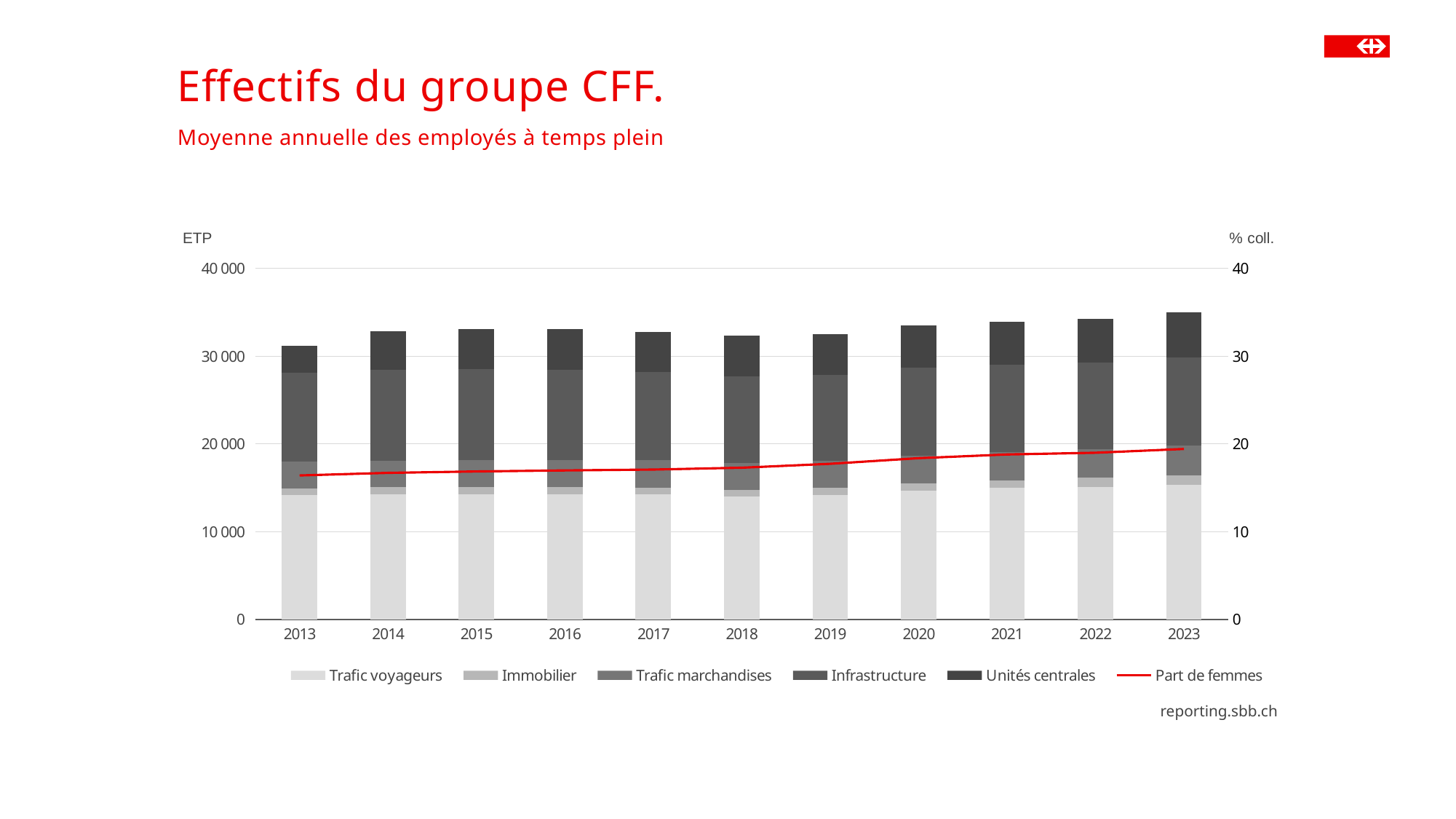
Is the total bar for 2013 greater or less than 30 000? greater Which year has the lowest total bar? 2013 Which year has the larger total bar, 2018 or 2021? 2021 How many years are shown on the x axis? 11 Is the Part de femmes value for 2013 greater or less than 20? less What is the title of the chart slide? Effectifs du groupe CFF. How many series does the legend list? 6 Is the total bar for 2023 greater or less than 40 000? less What kind of chart is shown on the slide? stacked bar chart with a line Does the Part de femmes line rise or fall from 2013 to 2023? rise What is the label of the left vertical axis? ETP Which year has the highest total bar? 2023